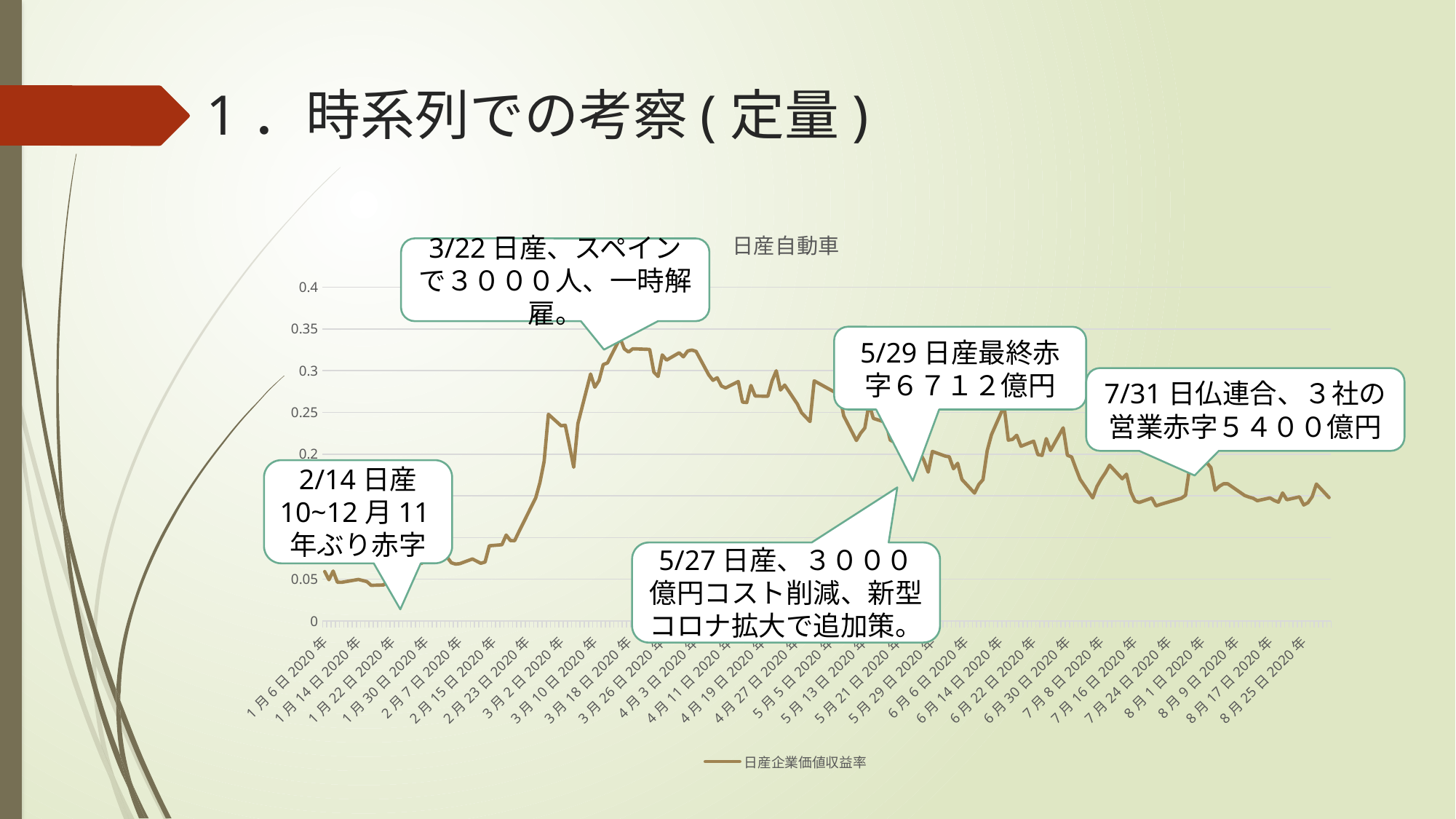
Does the line overall rise or fall from 3月26日 2020年 to 8月25日 2020年? fall Is the value for 3月18日 2020年 greater or less than 0.3? greater Does the line rise or fall from 1月6日 2020年 to 3月18日 2020年? rise Is the value for 1月22日 2020年 greater or less than 0.1? less Which has the larger value, 4月3日 2020年 or 7月8日 2020年? 4月3日 2020年 What is the title of the chart? 日産自動車 What series name is shown in the chart's legend? 日産企業価値収益率 What kind of chart is shown on the slide? line chart How many series does the chart's legend list? 1 Is the value for 5月29日 2020年 greater or less than 0.25? less Which has the larger value, 3月18日 2020年 or 1月22日 2020年? 3月18日 2020年